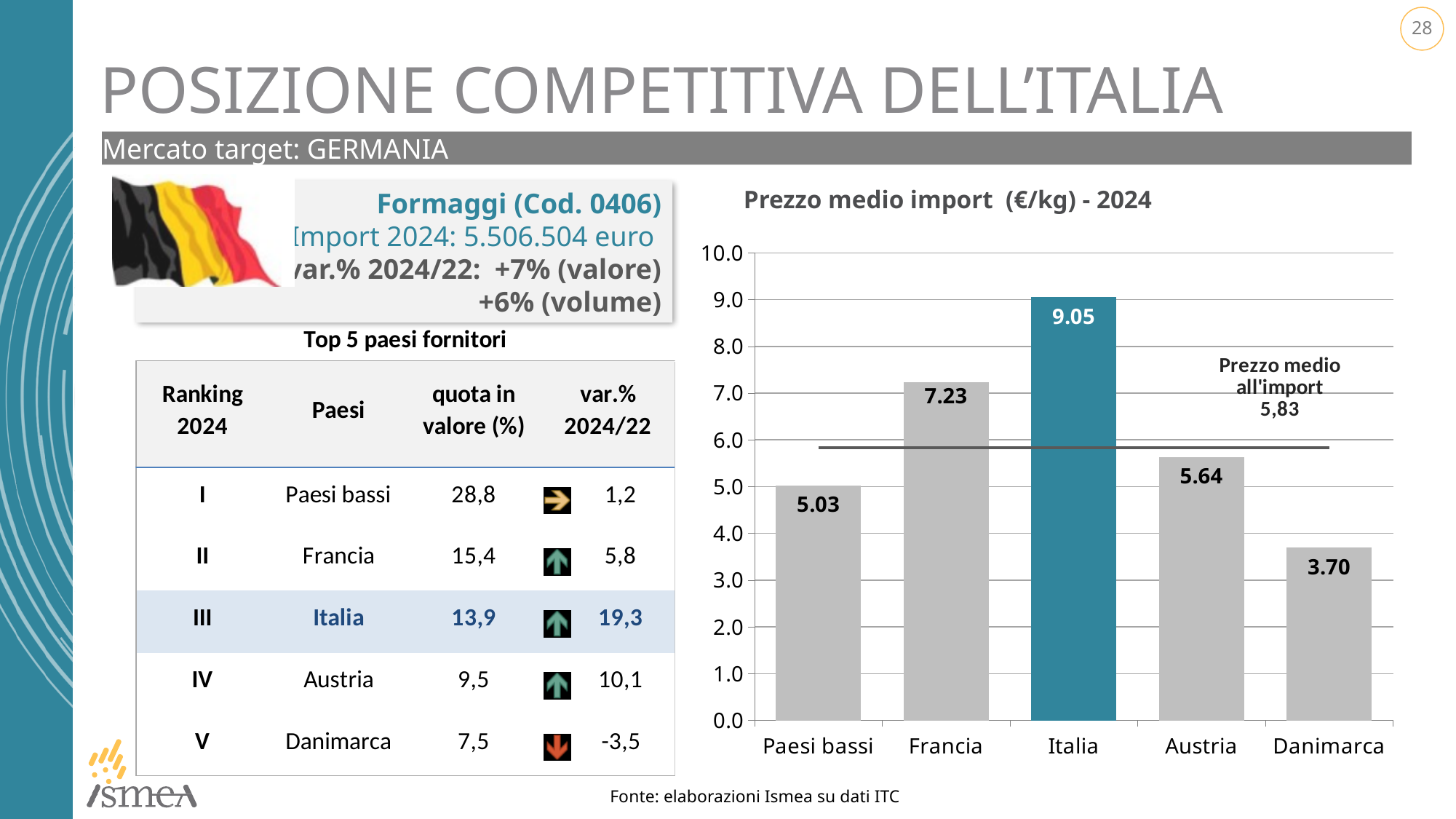
What is the difference between the average import price of Italia and Francia? 1.82 Which has a higher average import price, Austria or Paesi bassi? Austria What is the value of the overall average import price ('Prezzo medio all'import') shown as a horizontal line in the chart? 5,83 Which country has the lowest average import price in the chart? Danimarca How many countries are shown in the chart 'Prezzo medio import (€/kg) - 2024'? 5 What is the average import price for Italia in the chart 'Prezzo medio import (€/kg) - 2024'? 9.05 Which country has the highest average import price in the chart? Italia What is the average import price for Paesi bassi in the chart? 5.03 What kind of chart is 'Prezzo medio import (€/kg) - 2024'? Bar chart What is the average import price for Danimarca in the chart? 3.70 What is the difference between the average import price of Austria and Danimarca? 1.94 Which bar in the chart is highlighted in a different colour (teal) from the others? Italia